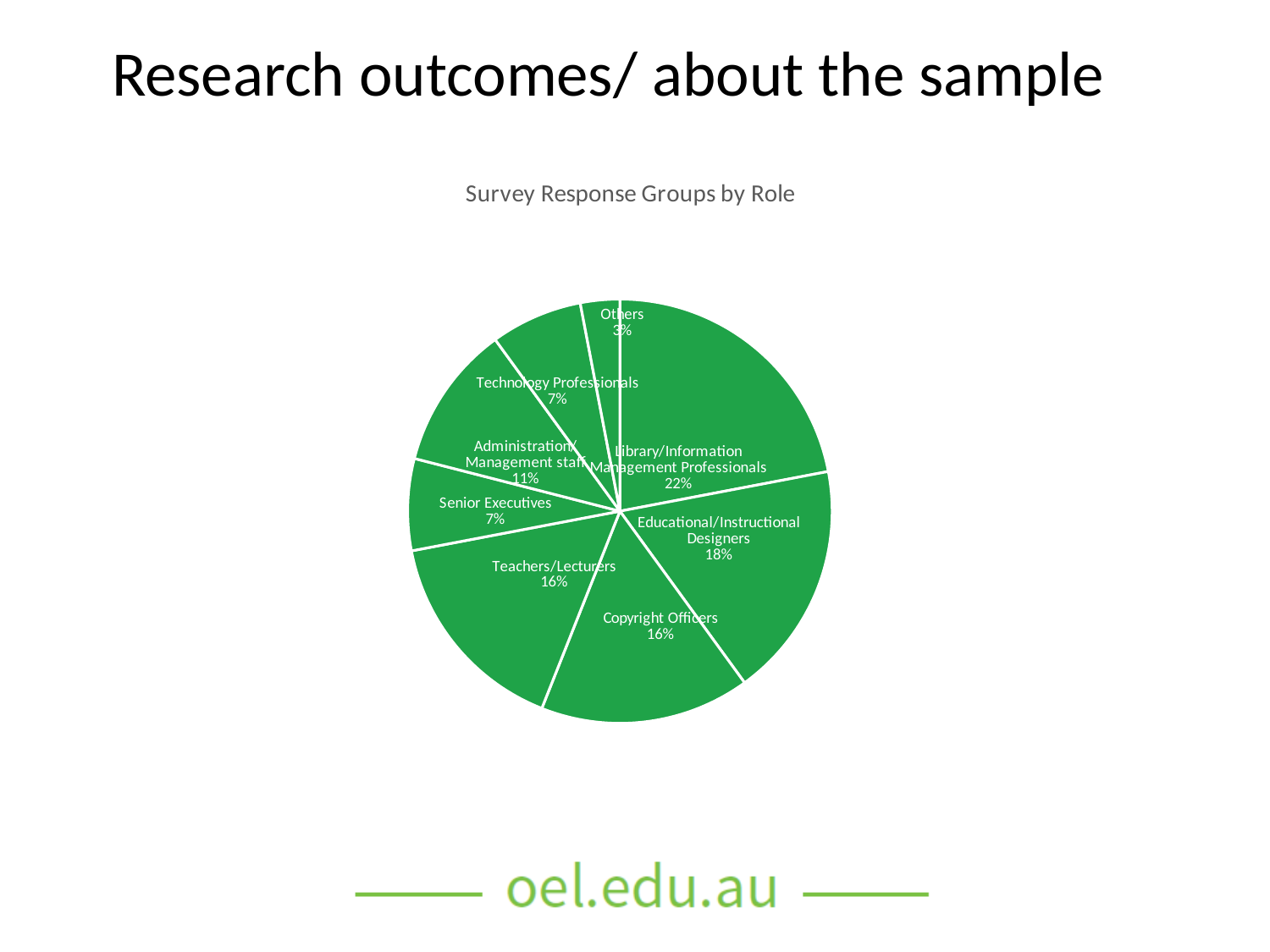
Which role group has the smallest share of the pie? Others What is the title of the chart? Survey Response Groups by Role What share of the pie do Copyright Officers represent? 16% What is the difference in percentage points between Library/Information Management Professionals and Teachers/Lecturers? 6 What percentage is shown for Others? 3% What share of survey responses came from Library/Information Management Professionals? 22% Which is larger, the share for Senior Executives or the share for Administration/Management staff? Administration/Management staff What type of chart is shown on the slide? pie chart What percentage of the pie is Educational/Instructional Designers? 18% What percentage is shown for Administration/Management staff? 11% How many slices does the pie chart have? 8 Which role group has the largest share of the pie? Library/Information Management Professionals